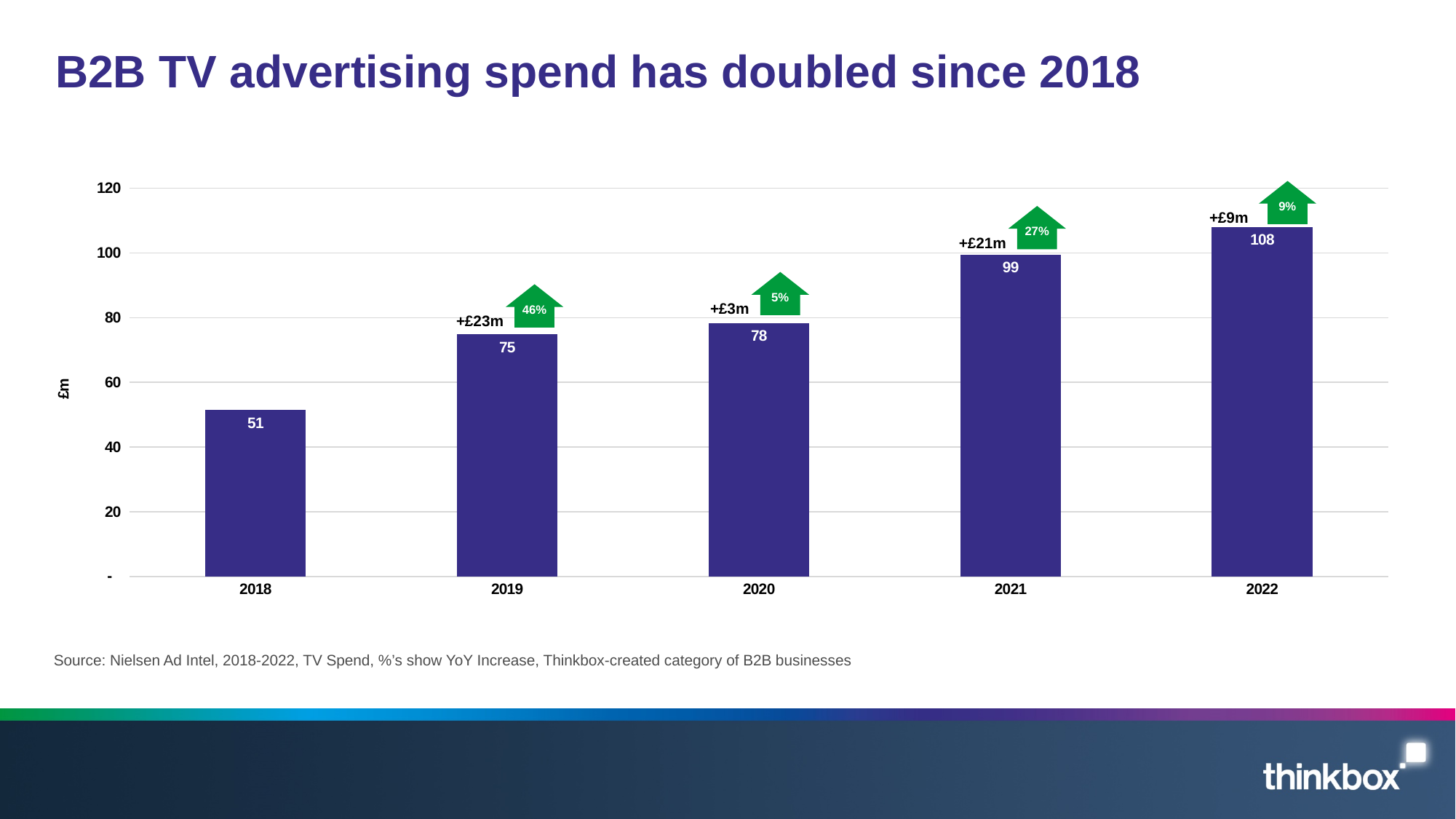
What is the difference between the 2021 and 2019 values? 24 Do the values rise or fall from 2018 to 2022? Rise What kind of chart is shown on the slide? Bar chart What year-on-year percentage increase is shown above the 2019 bar? 46% What value is shown for 2020? 78 Which year has the highest B2B TV advertising spend? 2022 How many years are shown on the x axis? 5 What unit is shown on the y axis label? £m What was the B2B TV advertising spend in 2018? 51 Which year has the larger value, 2020 or 2021? 2021 What was the B2B TV advertising spend in 2022? 108 Which year has the lowest B2B TV advertising spend? 2018